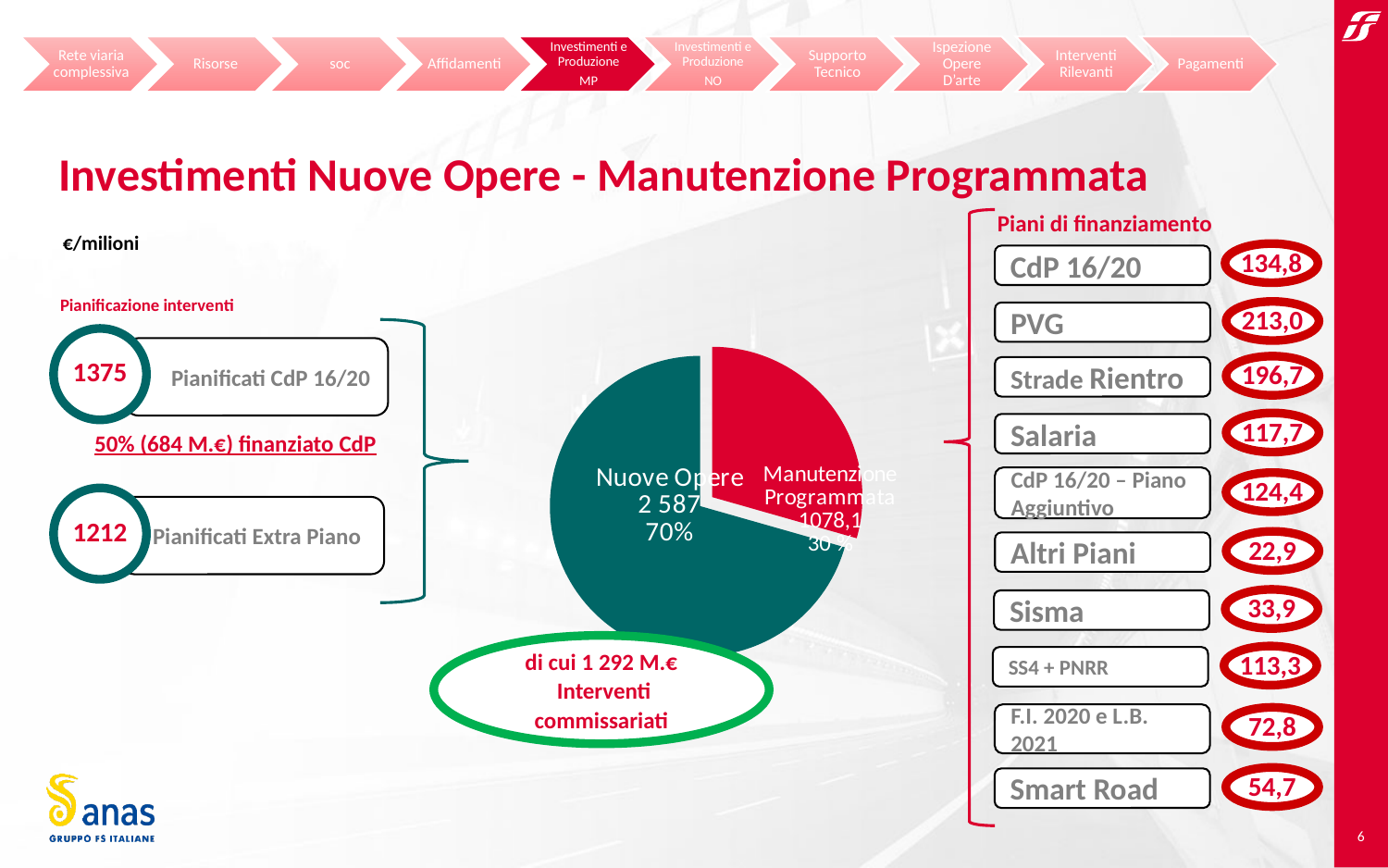
What kind of chart is shown on the slide? pie chart What share of the pie does Manutenzione Programmata represent? 30 % What colour is the Nuove Opere slice of the pie chart? dark green Which is larger in the pie chart, Nuove Opere or Manutenzione Programmata? Nuove Opere Which slice of the pie chart is the smallest? Manutenzione Programmata What is the value shown for Manutenzione Programmata in the pie chart? 1078,1 What is the value shown for Nuove Opere in the pie chart? 2 587 What colour is the Manutenzione Programmata slice of the pie chart? red What unit is stated for the values on the slide? €/milioni Which slice of the pie chart is the largest? Nuove Opere What share of the pie does Nuove Opere represent? 70% How many slices does the pie chart have? 2